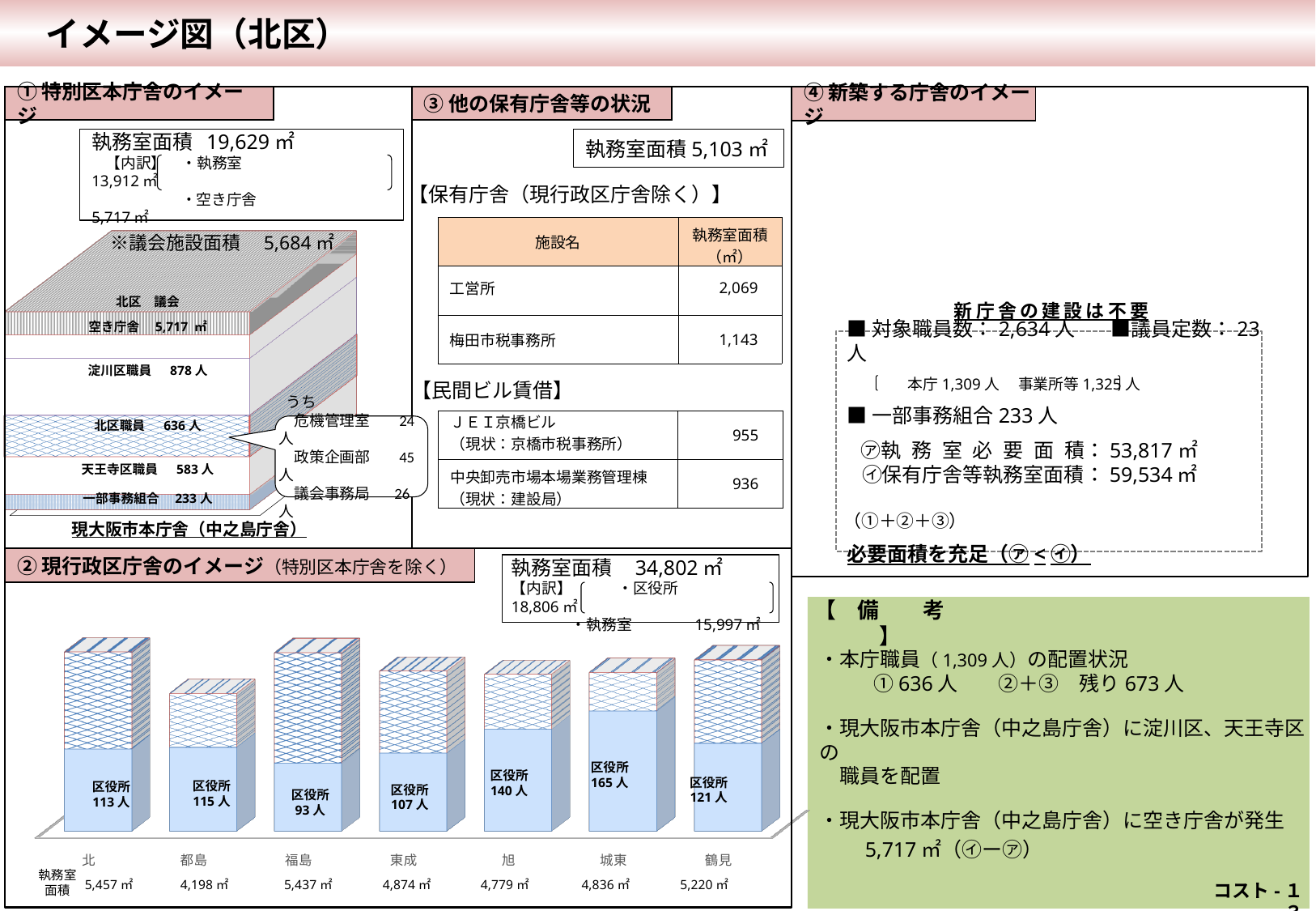
What kind of chart is shown in section ② (現行政区庁舎のイメージ)? bar chart In the chart in section ② (現行政区庁舎のイメージ), which ward has the highest number of 区役所 staff? 城東 In the chart in section ② (現行政区庁舎のイメージ), what is the difference in 区役所 staff between 城東 and 旭? 25 人 In the chart in section ② (現行政区庁舎のイメージ), how many 区役所 staff are shown for 城東? 165 人 In the chart in section ② (現行政区庁舎のイメージ), which has more 区役所 staff, 鶴見 or 東成? 鶴見 In the chart in section ② (現行政区庁舎のイメージ), how many wards are shown? 7 In the chart in section ② (現行政区庁舎のイメージ), how many 区役所 staff are shown for 福島? 93 人 In the chart in section ② (現行政区庁舎のイメージ), what is the 執務室面積 shown for 北? 5,457 ㎡ In the chart in section ② (現行政区庁舎のイメージ), what is the 執務室面積 shown for 都島? 4,198 ㎡ In the chart in section ② (現行政区庁舎のイメージ), which ward has the smallest 執務室面積? 都島 In the chart in section ② (現行政区庁舎のイメージ), which ward has the lowest number of 区役所 staff? 福島 In the chart in section ② (現行政区庁舎のイメージ), what is the difference in 執務室面積 between 北 and 鶴見? 237 ㎡